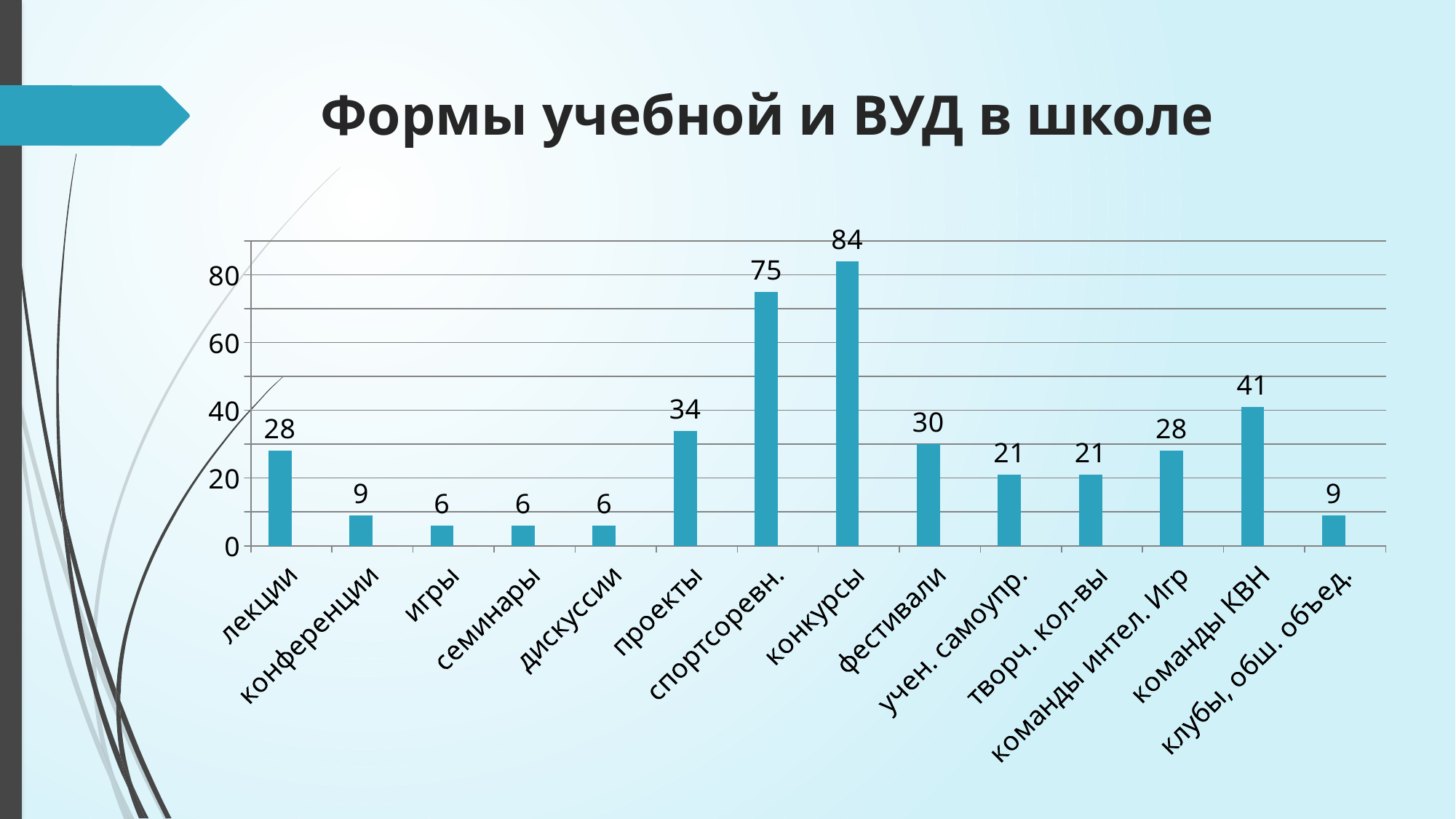
Is the value for спортсоревн. greater or less than 60? greater What kind of chart is shown on the slide? bar chart What is the value for проекты? 34 Which is larger, the value for проекты or the value for фестивали? проекты What is the title of the chart? Формы учебной и ВУД в школе What is the difference between the values for конкурсы and спортсоревн.? 9 Which category has the highest value? конкурсы What is the value for фестивали? 30 What is the difference between the values for команды КВН and лекции? 13 What is the value for команды КВН? 41 How many categories are shown on the x axis? 14 What is the value for конкурсы? 84